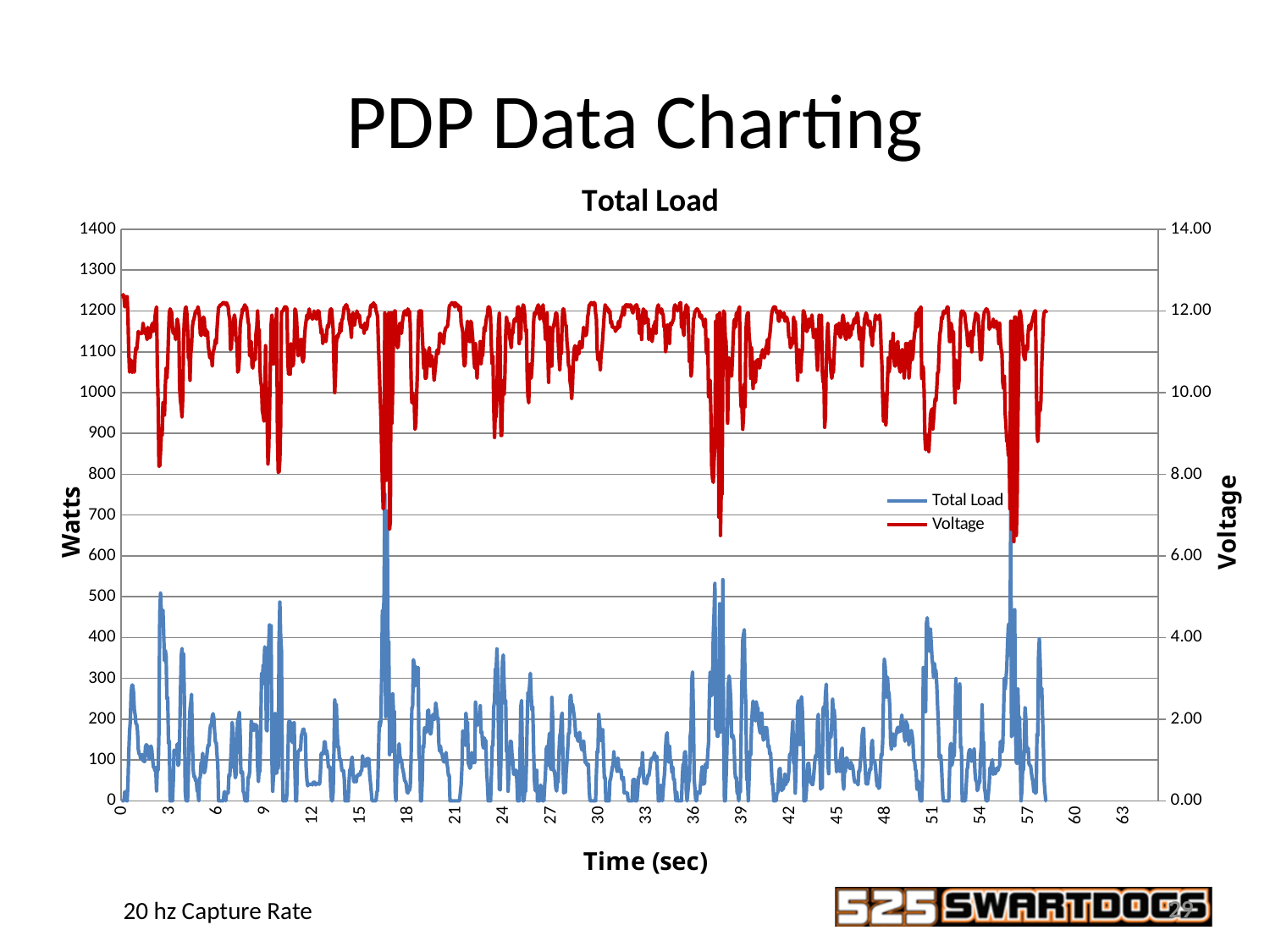
What are the two series named in the legend? Total Load and Voltage Is the Voltage value at 30 seconds greater or less than 10.00? greater How many series does the legend list? 2 What kind of chart is shown on the slide? line chart Is the highest Total Load value on the chart greater or less than 1000 watts? less Is the highest Total Load value reached on the chart greater or less than 600 watts? greater What is the title of the chart? Total Load